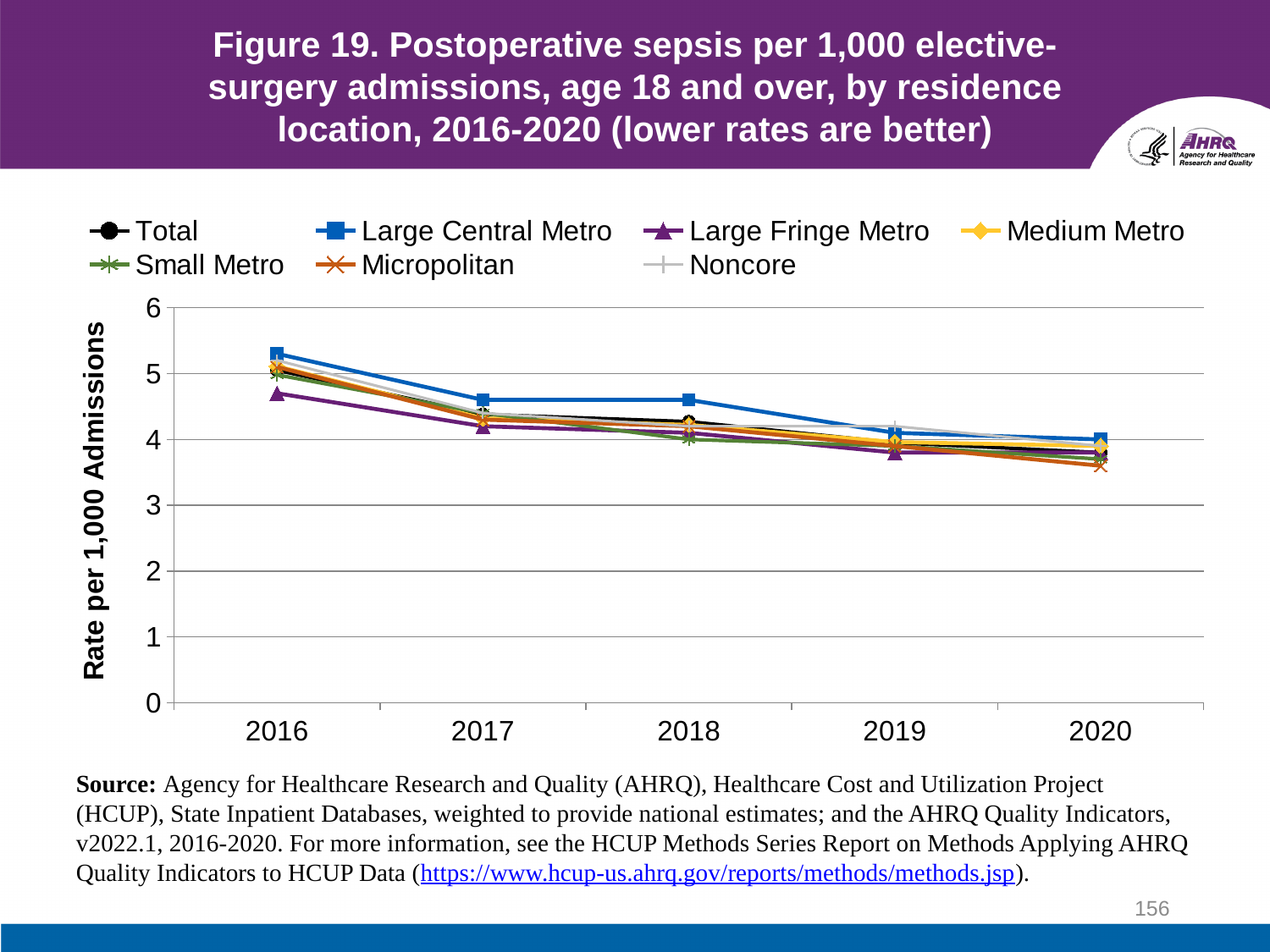
Which residence location has the lowest rate in 2016? Large Fringe Metro How many series does the legend list? 7 Is the value for Large Central Metro in 2016 greater or less than 5? greater What is the title of the y axis? Rate per 1,000 Admissions Does the Large Central Metro rate rise or fall from 2016 to 2020? Fall In 2017, which is larger: the rate for Large Central Metro or for Large Fringe Metro? Large Central Metro What kind of chart is shown on the slide? Line chart Is the value for Micropolitan in 2020 greater or less than 4? less Which residence location has the highest rate in 2016? Large Central Metro Is the value for Large Fringe Metro in 2016 greater or less than 5? less How many years are shown along the x axis? 5